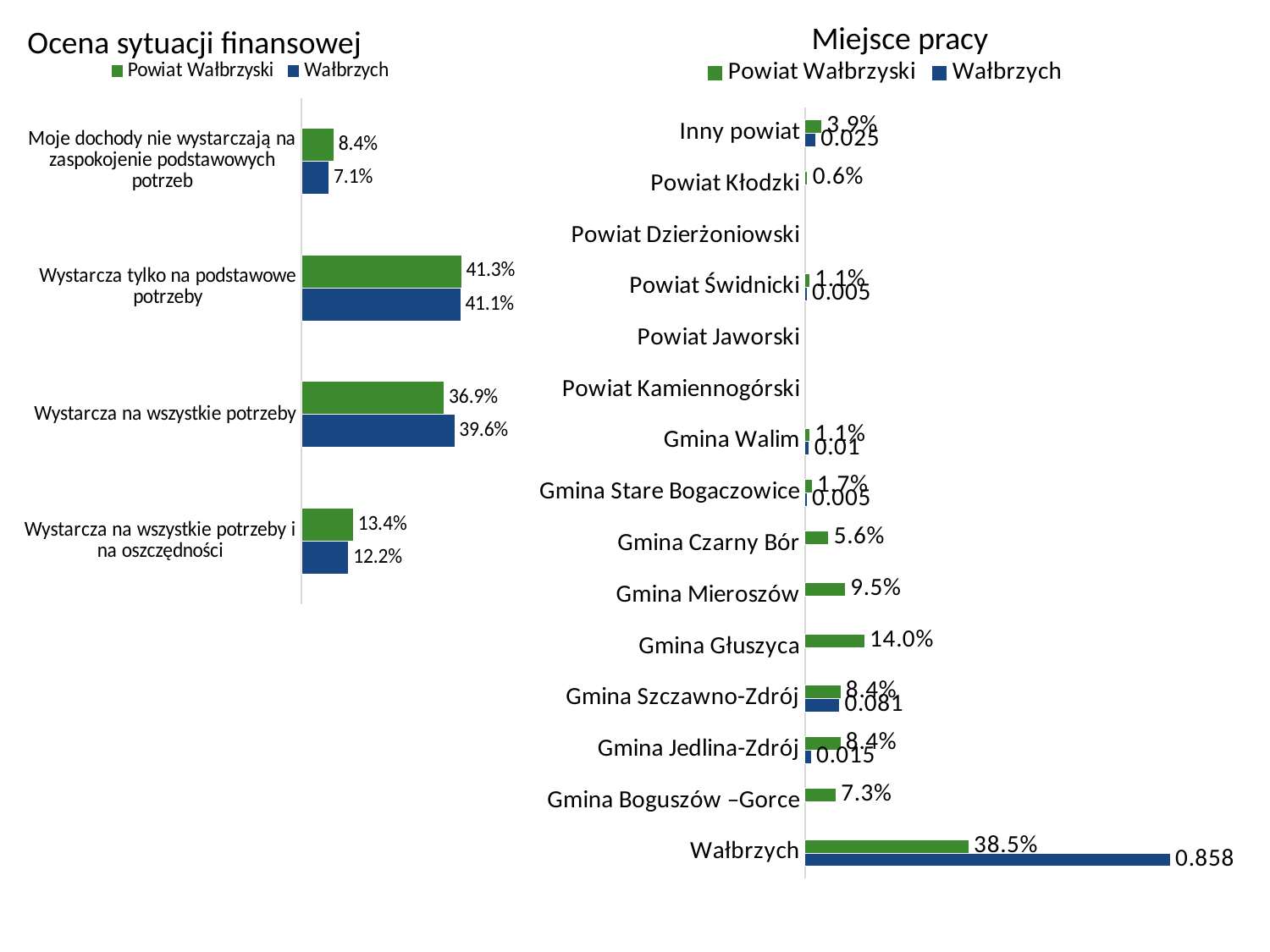
In the 'Miejsce pracy' chart, which category has the highest value for Powiat Wałbrzyski? Wałbrzych In the 'Ocena sytuacji finansowej' chart, which category has the lowest value for Wałbrzych? Moje dochody nie wystarczają na zaspokojenie podstawowych potrzeb How many categories does the 'Ocena sytuacji finansowej' chart show? 4 How many series does the legend of the 'Miejsce pracy' chart list? 2 In the 'Ocena sytuacji finansowej' chart, which is larger for 'Wystarcza na wszystkie potrzeby': Powiat Wałbrzyski or Wałbrzych? Wałbrzych In the 'Ocena sytuacji finansowej' chart, what is the value for Wałbrzych for 'Wystarcza na wszystkie potrzeby'? 39.6% In the 'Ocena sytuacji finansowej' chart, what is the value for Powiat Wałbrzyski for 'Wystarcza tylko na podstawowe potrzeby'? 41.3% In the 'Miejsce pracy' chart, what is the value for Powiat Wałbrzyski for Gmina Głuszyca? 14.0% In the 'Miejsce pracy' chart, what is the value for Wałbrzych for the category Wałbrzych? 0.858 In the 'Ocena sytuacji finansowej' chart, what is the difference between Powiat Wałbrzyski and Wałbrzych for 'Wystarcza na wszystkie potrzeby i na oszczędności'? 1.2% What kind of chart is the 'Miejsce pracy' chart? Bar chart In the 'Miejsce pracy' chart, which is larger for Powiat Wałbrzyski: Gmina Mieroszów or Gmina Czarny Bór? Gmina Mieroszów